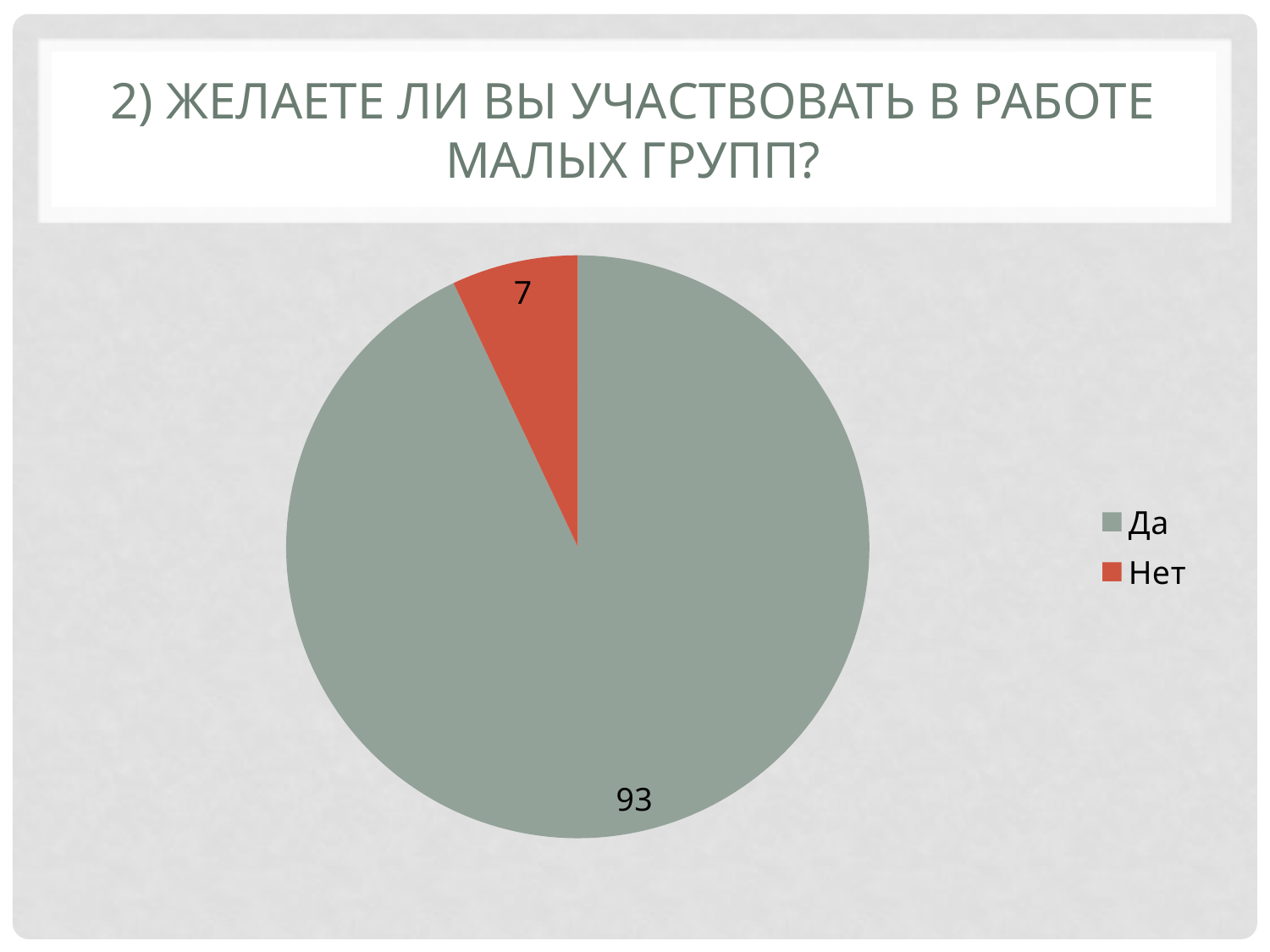
Which category has the smallest slice of the pie? Нет What share of the pie does the "Нет" slice represent? 7% What is the value for the "Нет" slice? 7 What kind of chart is shown on the slide? pie chart Which category has the largest slice of the pie? Да How many slices does the pie chart have? 2 How many entries does the legend list? 2 What is the difference between the values for "Да" and "Нет"? 86 Which is larger, the value for "Да" or the value for "Нет"? Да What colour is the "Нет" slice in the pie chart? red What share of the pie does the "Да" slice represent? 93% What is the value for the "Да" slice? 93